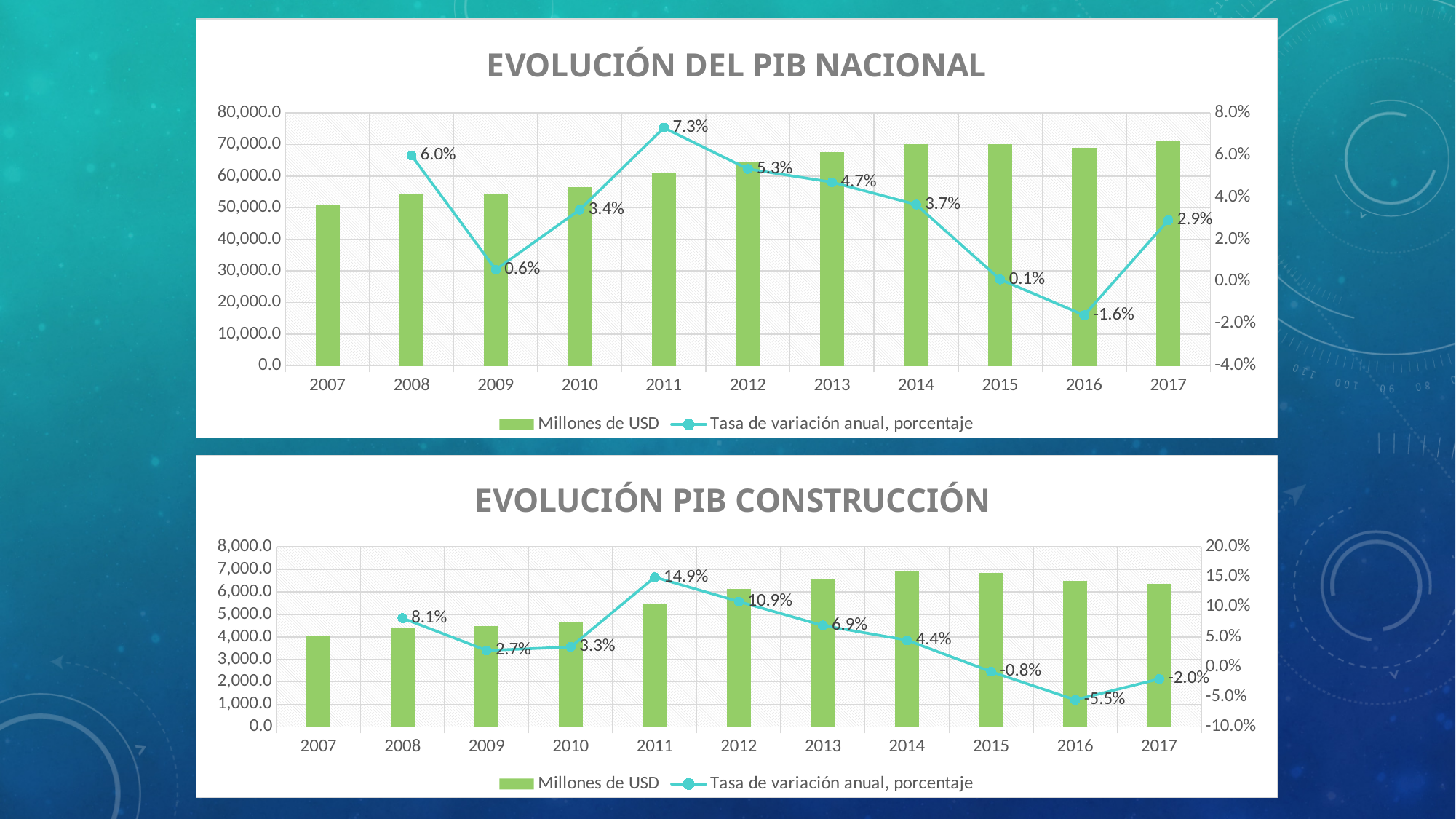
In the 'Evolución del PIB Nacional' chart, what is the annual variation rate (Tasa de variación anual) for 2011? 7.3% In the 'Evolución del PIB Nacional' chart, which year has the highest annual variation rate? 2011 In the 'Evolución PIB Construcción' chart, is the Millones de USD value for 2011 greater or less than 5,000.0? greater In the 'Evolución PIB Construcción' chart, what is the annual variation rate for 2015? -0.8% In the 'Evolución PIB Construcción' chart, is the annual variation rate for 2008 larger or smaller than the rate for 2013? larger In the 'Evolución PIB Construcción' chart, what is the annual variation rate for 2011? 14.9% How many years are shown on the x axis of the 'Evolución PIB Construcción' chart? 11 In the 'Evolución del PIB Nacional' chart, what is the difference in percentage points between the annual variation rate in 2011 and in 2012? 2.0 percentage points In the 'Evolución del PIB Nacional' chart, which year has the lowest annual variation rate? 2016 In the 'Evolución del PIB Nacional' chart, what is the annual variation rate for 2016? -1.6% In the 'Evolución del PIB Nacional' chart, is the Millones de USD value for 2016 greater or less than 60,000.0? greater In the 'Evolución PIB Construcción' chart, which year has the lowest annual variation rate? 2016